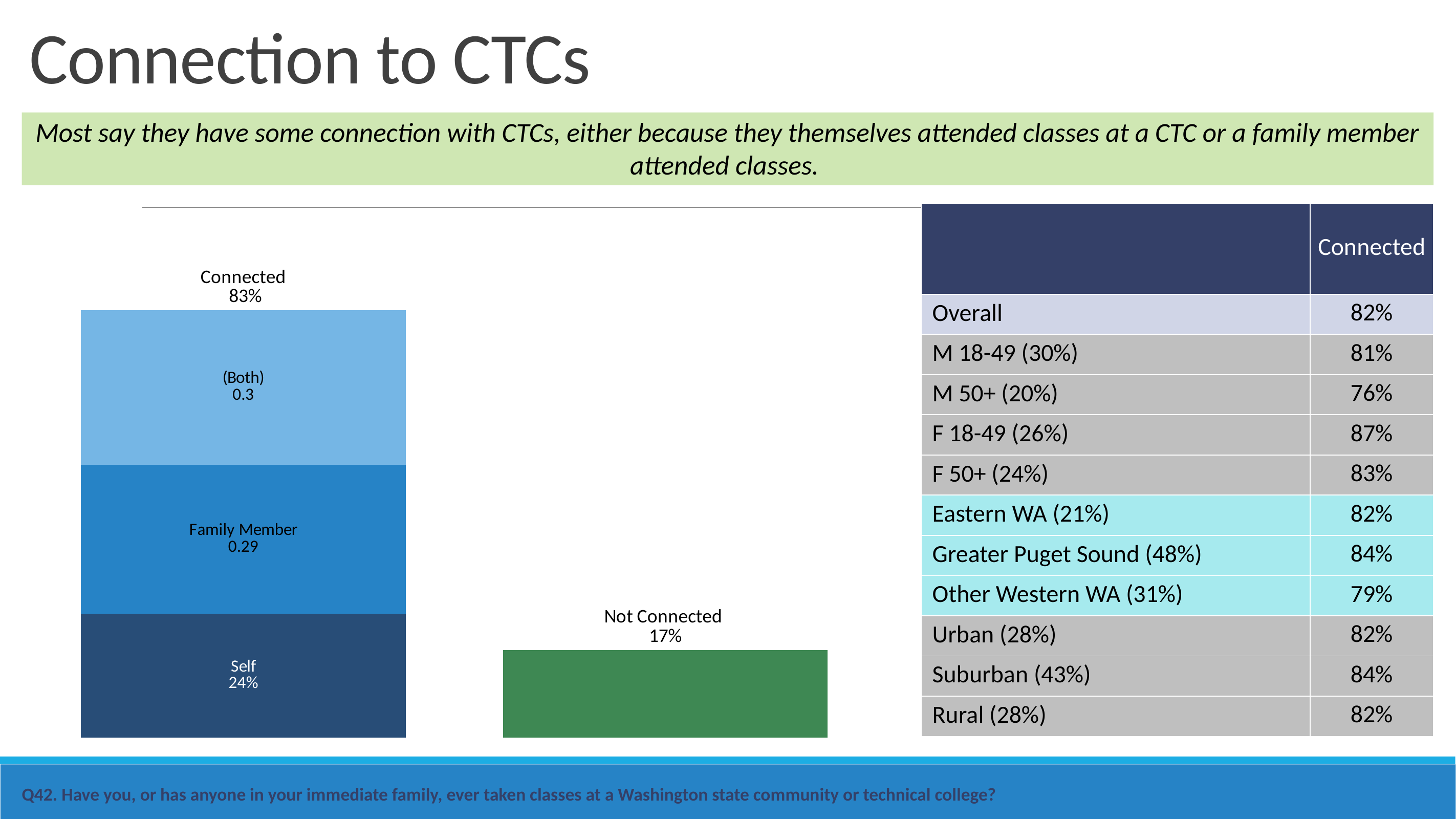
What kind of chart is shown on the left of the slide? Stacked bar chart Which bar is taller, Connected or Not Connected? Connected What value is shown for the Self segment of the Connected bar? 24% How many bars are plotted in the chart? 2 What is the value labelled for the Connected bar? 83% What is the difference between the Connected value and the Not Connected value? 66% What is the value labelled for the Not Connected bar? 17% What value is shown for the Family Member segment of the Connected bar? 0.29 Which segment is at the bottom of the Connected stacked bar? Self What colour is the Not Connected bar? Green What value is shown for the (Both) segment of the Connected bar? 0.3 How many segments make up the Connected bar? 3